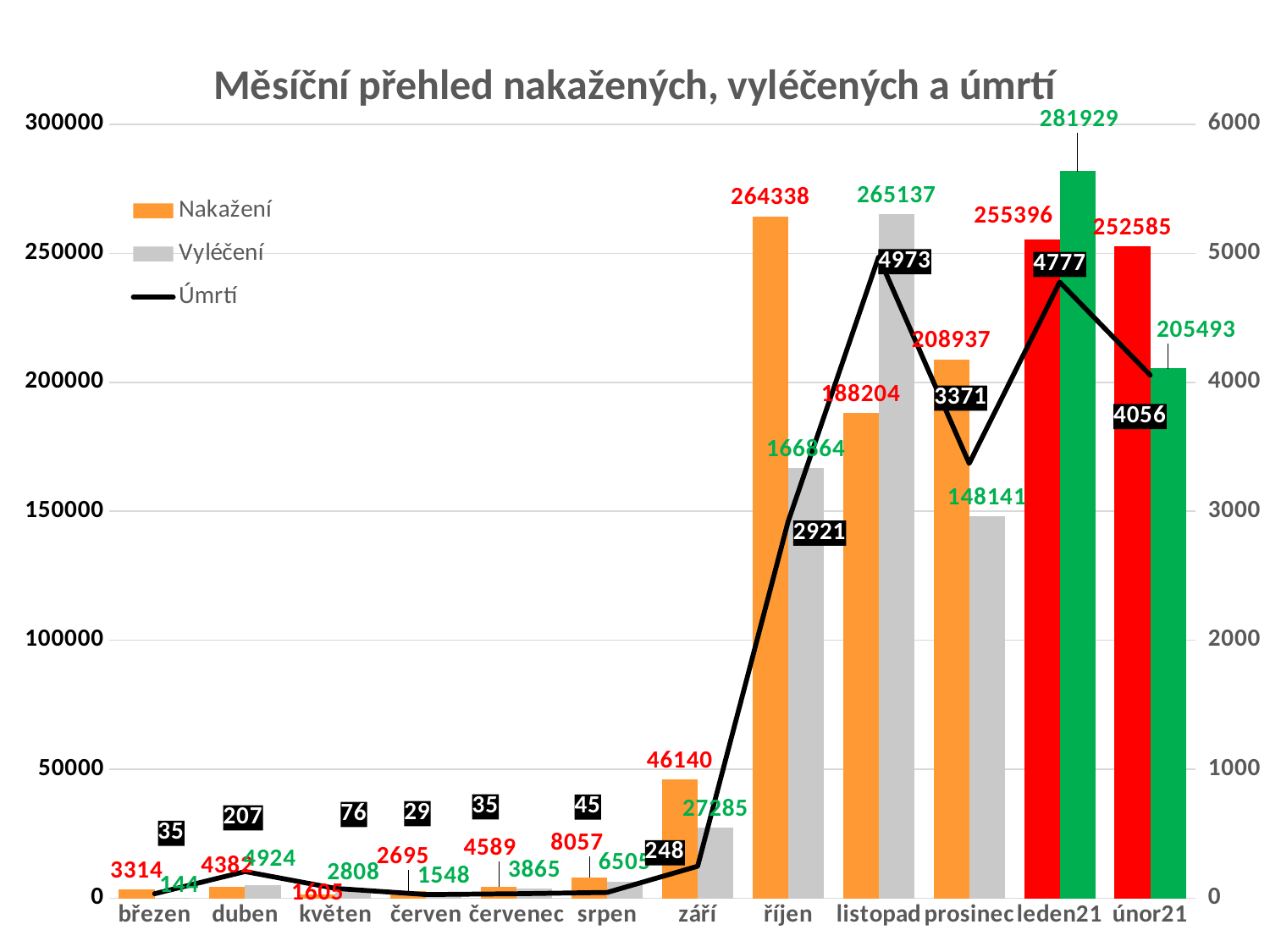
Which month has the highest Nakažení value? říjen Which month has the highest Úmrtí value? listopad What is the Vyléčení value for leden21? 281929 How many series does the legend list? 3 Which is larger for prosinec, the Nakažení value or the Vyléčení value? Nakažení What is the Úmrtí value for listopad? 4973 Which month has the lowest Vyléčení value? březen How many months are shown on the x axis? 12 What is the difference between the Nakažení and Vyléčení values for říjen? 97474 Is the Nakažení value for září greater or less than 50000? less What is the Nakažení value for říjen? 264338 Does the Úmrtí line rise or fall from listopad to prosinec? fall